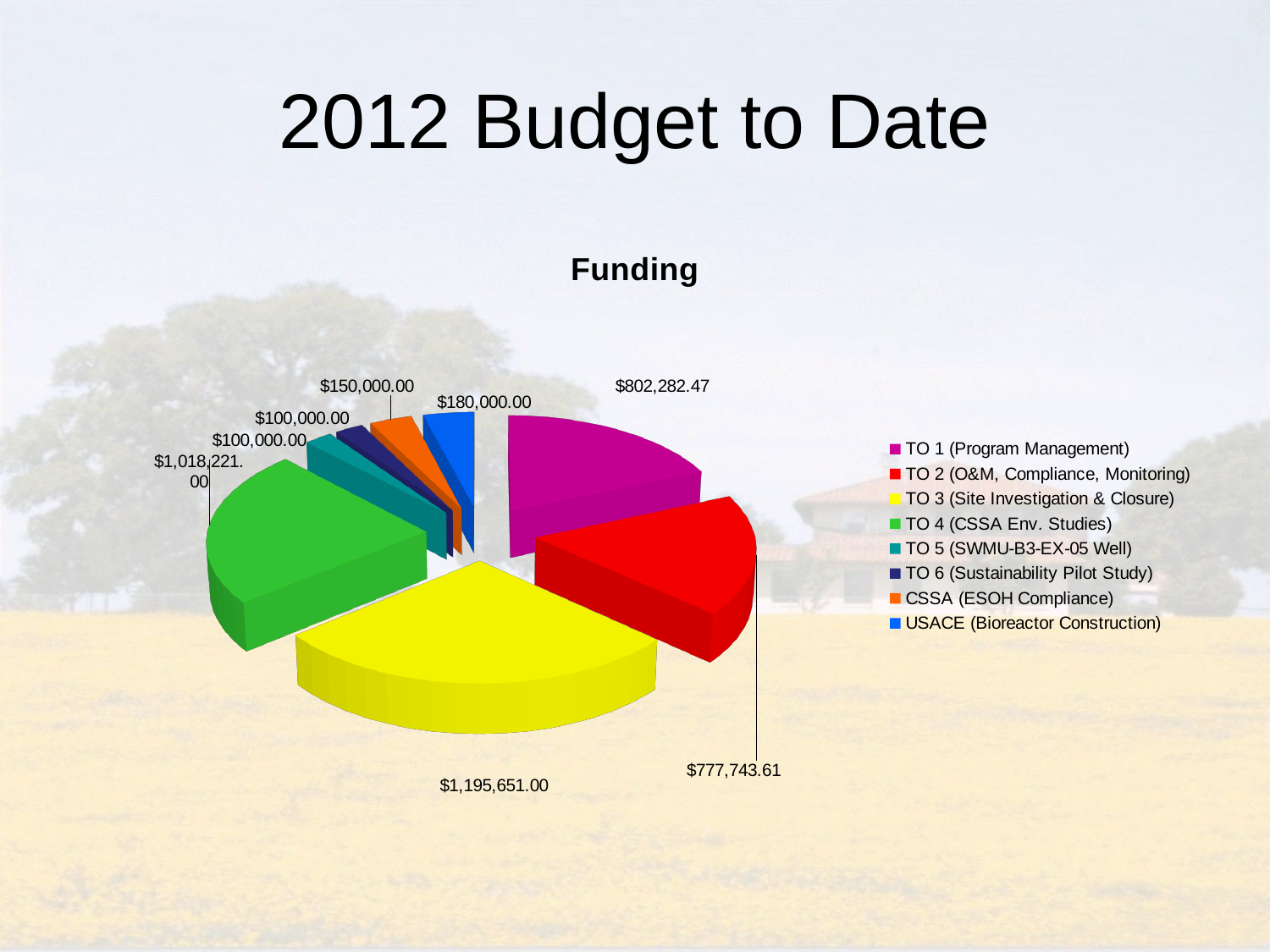
What type of chart is shown on the slide? pie chart What is the funding value for USACE (Bioreactor Construction)? $180,000.00 What is the funding value for TO 3 (Site Investigation & Closure)? $1,195,651.00 How many slices does the pie chart have? 8 What is the funding value for CSSA (ESOH Compliance)? $150,000.00 Which category has the largest funding value? TO 3 (Site Investigation & Closure) What is the title of the chart? Funding What is the difference between the funding for TO 3 (Site Investigation & Closure) and TO 4 (CSSA Env. Studies)? $177,430.00 Which is larger, the funding for TO 4 (CSSA Env. Studies) or TO 1 (Program Management)? TO 4 (CSSA Env. Studies) What is the funding value for TO 1 (Program Management)? $802,282.47 What is the difference between the funding for TO 1 (Program Management) and TO 2 (O&M, Compliance, Monitoring)? $24,538.86 What colour is the slice for TO 2 (O&M, Compliance, Monitoring)? red